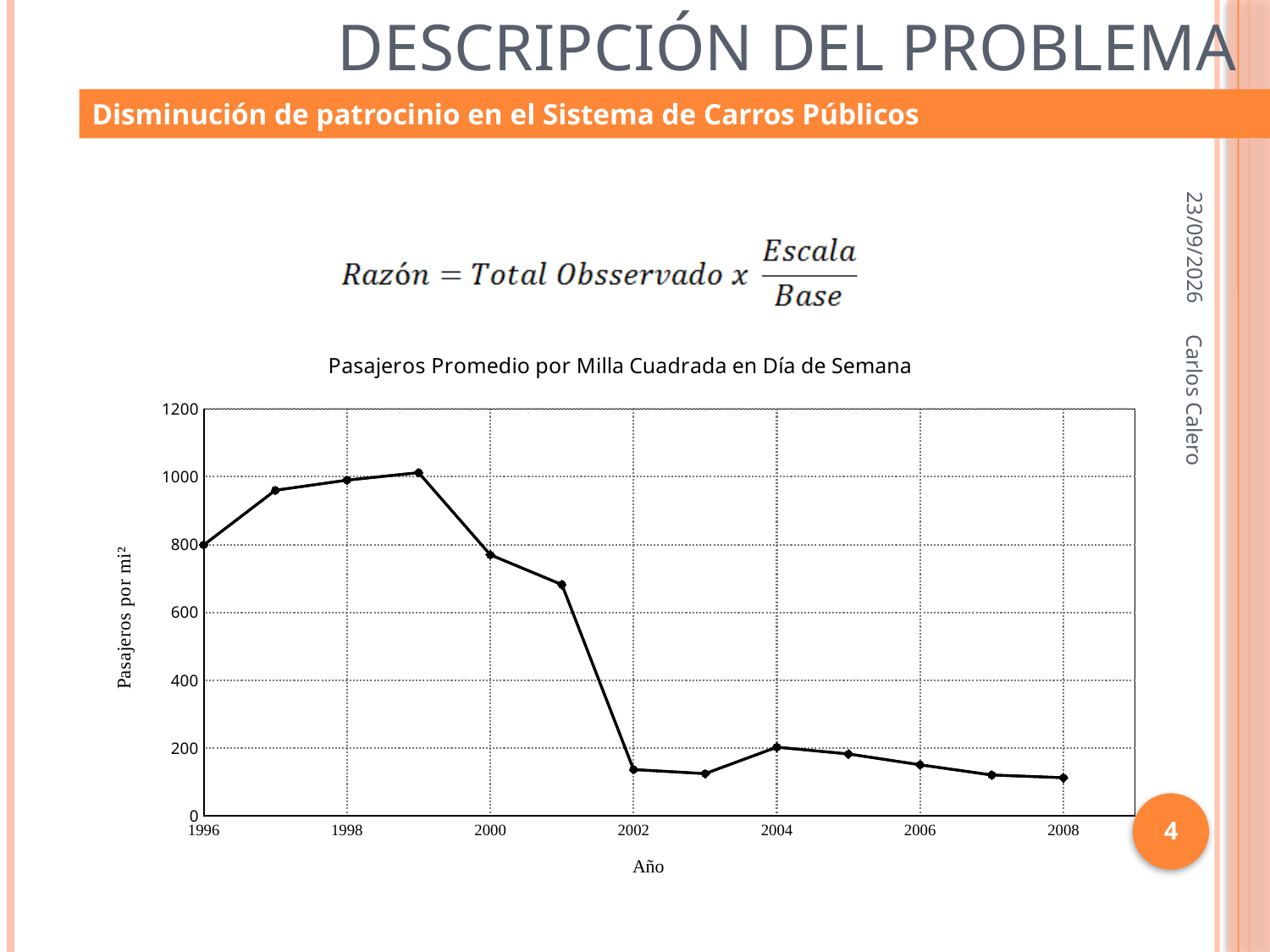
What is the label of the y axis of the chart? Pasajeros por mi² Is the value for 2002 greater or less than 200? less What is the title of the chart? Pasajeros Promedio por Milla Cuadrada en Día de Semana How many data points are plotted on the chart? 13 Is the value for 2001 greater or less than 600? greater Is the value for 2000 greater or less than 800? less Overall, do the values rise or fall from 1996 to 2008? fall In which year is the value highest? 1999 Which is larger, the value for 1998 or the value for 2006? 1998 What kind of chart is shown on the slide? line chart